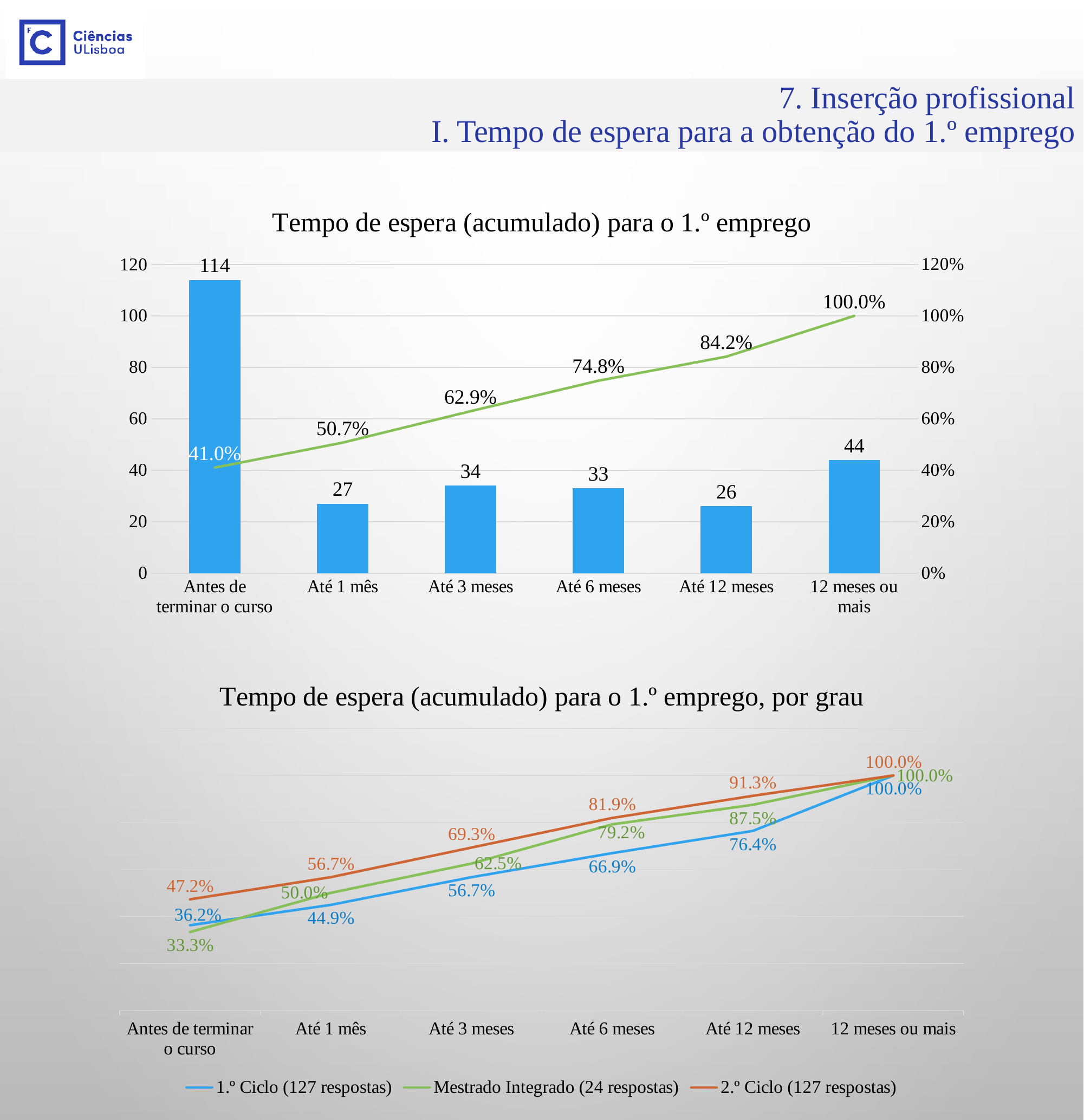
In the chart 'Tempo de espera (acumulado) para o 1.º emprego', what is the difference between the bar values for 'Antes de terminar o curso' and '12 meses ou mais'? 70 In the chart 'Tempo de espera (acumulado) para o 1.º emprego', does the cumulative percentage line rise or fall along the x axis? rise In the chart 'Tempo de espera (acumulado) para o 1.º emprego, por grau', which is larger at 'Até 12 meses': '1.º Ciclo (127 respostas)' or '2.º Ciclo (127 respostas)'? 2.º Ciclo (127 respostas) In the chart 'Tempo de espera (acumulado) para o 1.º emprego', how many categories are on the x axis? 6 In the chart 'Tempo de espera (acumulado) para o 1.º emprego', which category has the highest bar? Antes de terminar o curso What kind of chart is 'Tempo de espera (acumulado) para o 1.º emprego, por grau'? line chart In the chart 'Tempo de espera (acumulado) para o 1.º emprego', what is the bar value for 'Até 3 meses'? 34 In the chart 'Tempo de espera (acumulado) para o 1.º emprego', what cumulative percentage is shown at 'Até 6 meses'? 74.8% In the chart 'Tempo de espera (acumulado) para o 1.º emprego', which category has the lowest bar? Até 12 meses In the chart 'Tempo de espera (acumulado) para o 1.º emprego, por grau', how many series does the legend list? 3 In the chart 'Tempo de espera (acumulado) para o 1.º emprego, por grau', what is the value for '2.º Ciclo (127 respostas)' at 'Até 3 meses'? 69.3% In the chart 'Tempo de espera (acumulado) para o 1.º emprego, por grau', what is the value for 'Mestrado Integrado (24 respostas)' at 'Antes de terminar o curso'? 33.3%